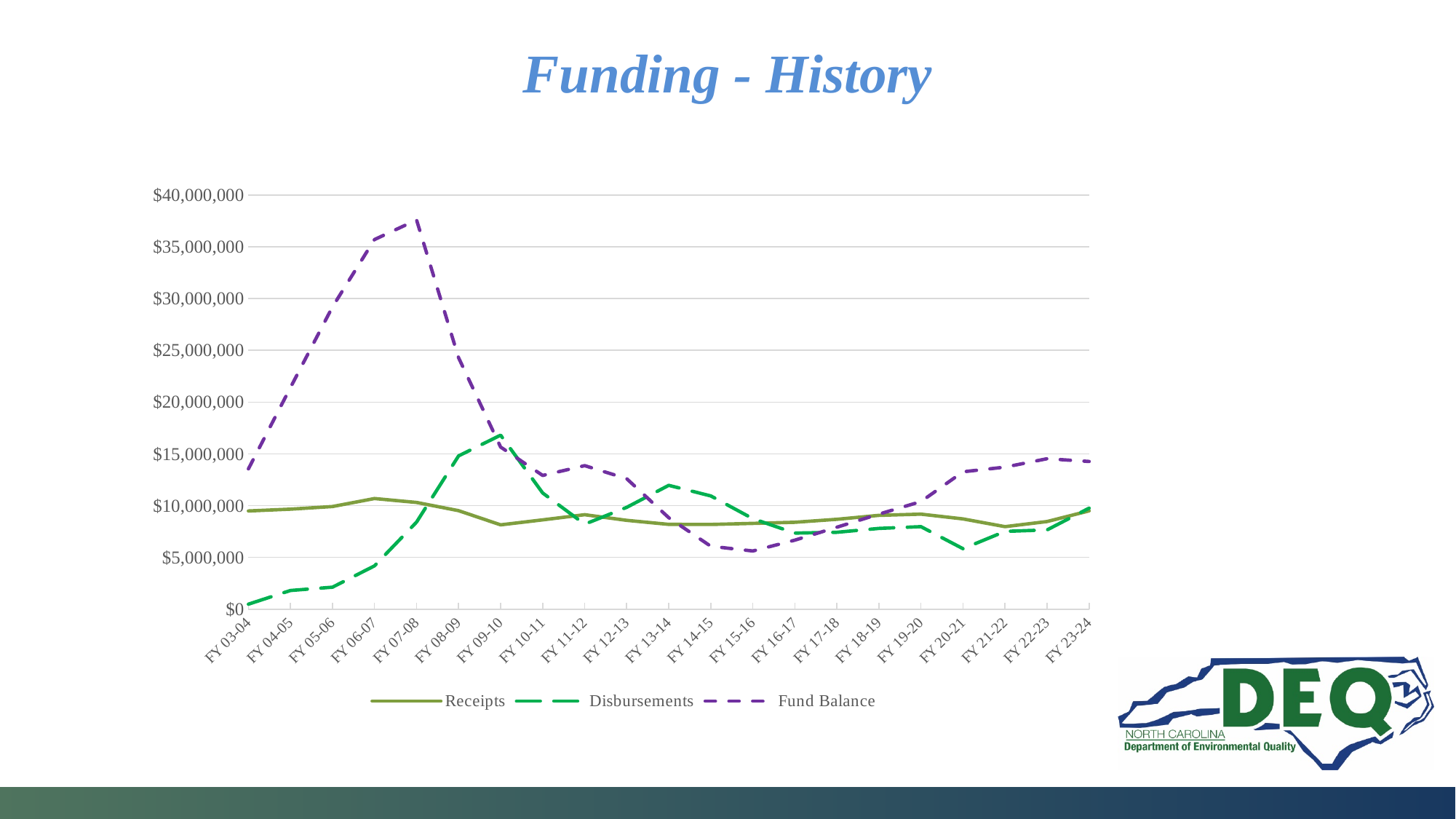
In FY 09-10, which is larger: Receipts or Disbursements? Disbursements What is the title of the chart? Funding - History What kind of chart is shown on the slide? Line chart How many series does the legend list? 3 Does the Fund Balance rise or fall between FY 07-08 and FY 15-16? Fall In which fiscal year are Disbursements at their lowest? FY 03-04 In which fiscal year are Disbursements at their highest? FY 09-10 In which fiscal year does the Fund Balance reach its highest value? FY 07-08 How many fiscal years are plotted along the x axis? 21 Is the Fund Balance in FY 07-08 greater or less than $35,000,000? greater Is the Fund Balance in FY 15-16 greater or less than $10,000,000? less Is the value for Disbursements in FY 03-04 greater or less than $5,000,000? less